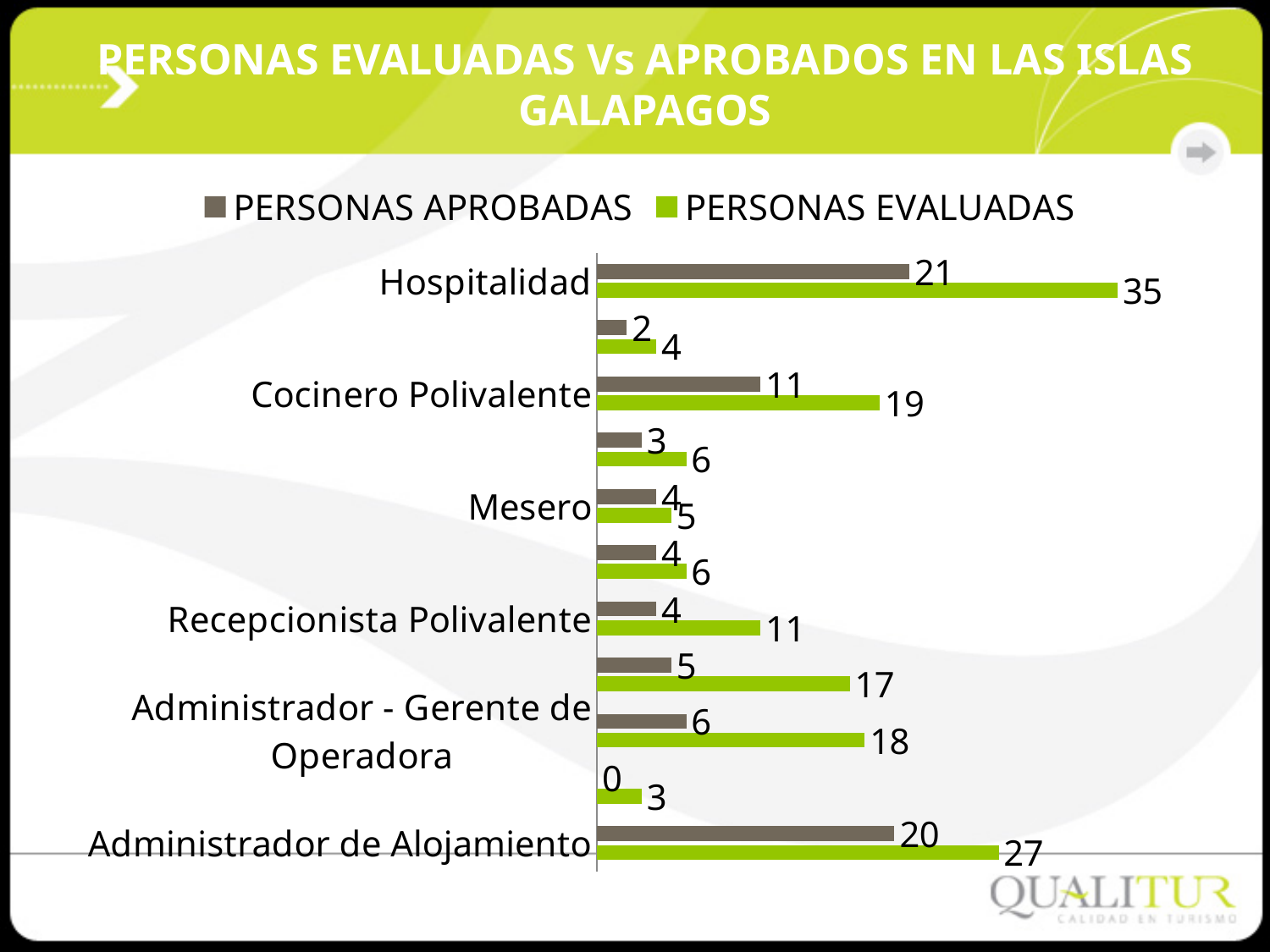
How many series does the legend list? 2 What is the value of PERSONAS EVALUADAS for Administrador - Gerente de Operadora? 18 Which labelled category has the highest value for PERSONAS EVALUADAS? Hospitalidad What is the value of PERSONAS EVALUADAS for Hospitalidad? 35 What is the value of PERSONAS APROBADAS for Administrador de Alojamiento? 20 What is the difference between PERSONAS EVALUADAS and PERSONAS APROBADAS for Cocinero Polivalente? 8 What is the value of PERSONAS APROBADAS for Cocinero Polivalente? 11 Which is larger: PERSONAS EVALUADAS for Hospitalidad or PERSONAS EVALUADAS for Administrador de Alojamiento? Hospitalidad Which labelled category has the highest value for PERSONAS APROBADAS? Hospitalidad What kind of chart is shown on the slide? Bar chart What colour represents PERSONAS EVALUADAS in the legend? Green What is the difference between PERSONAS EVALUADAS and PERSONAS APROBADAS for Hospitalidad? 14